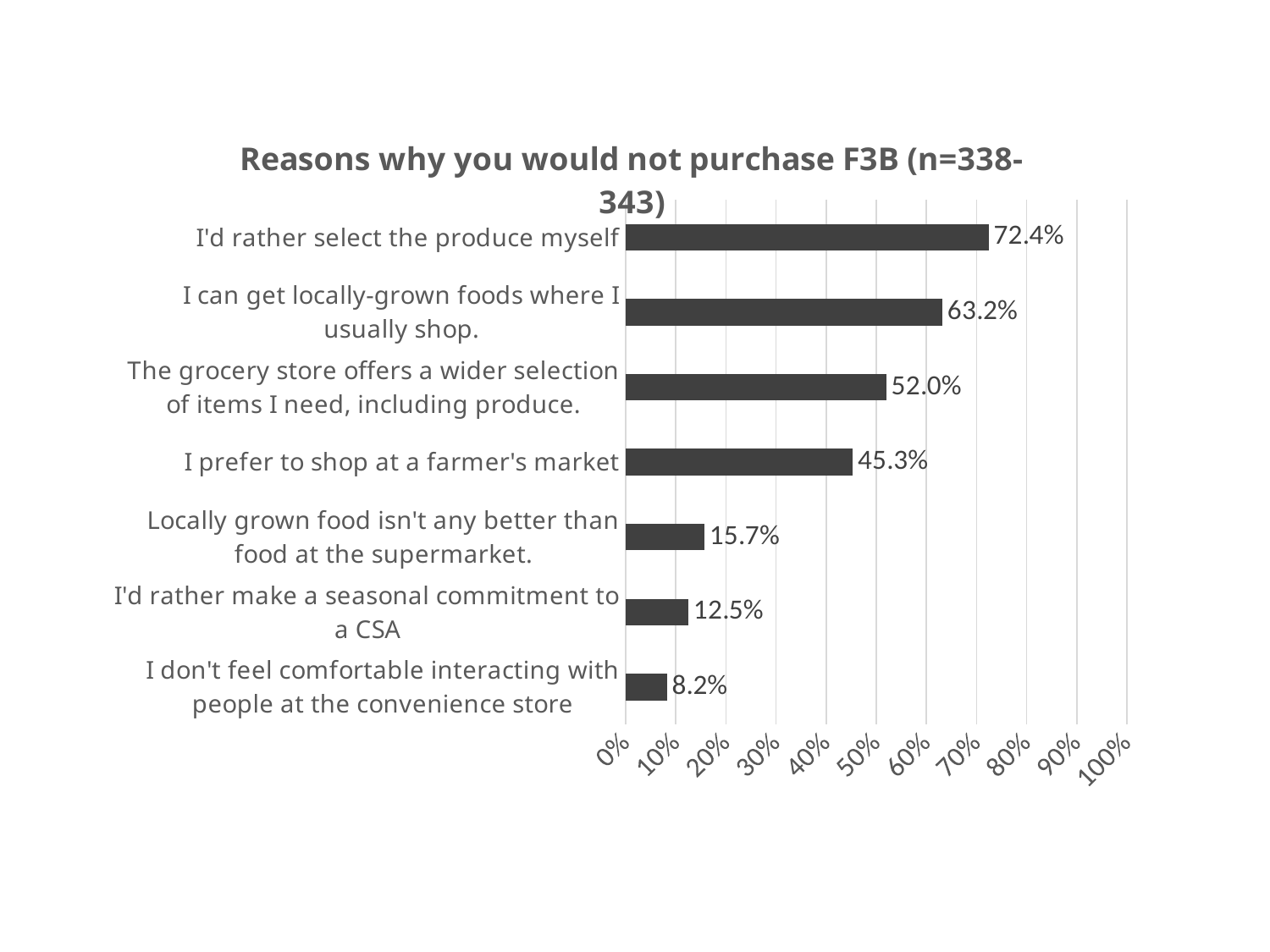
What kind of chart is shown on the slide? bar chart How many reasons are shown in the chart? 7 What is the difference between "I'd rather make a seasonal commitment to a CSA" and "I don't feel comfortable interacting with people at the convenience store"? 4.3% Which reason has the highest percentage? I'd rather select the produce myself What percentage of respondents said "I'd rather select the produce myself"? 72.4% What is the difference between "I'd rather select the produce myself" and "I can get locally-grown foods where I usually shop."? 9.2% Which reason has the lowest percentage? I don't feel comfortable interacting with people at the convenience store Which is larger: "The grocery store offers a wider selection of items I need, including produce." or "I prefer to shop at a farmer's market"? The grocery store offers a wider selection of items I need, including produce. What percentage chose "I'd rather make a seasonal commitment to a CSA"? 12.5% Is the value for "Locally grown food isn't any better than food at the supermarket." greater or less than 20%? less What is the title of the chart? Reasons why you would not purchase F3B (n=338-343) What is the value for "I prefer to shop at a farmer's market"? 45.3%